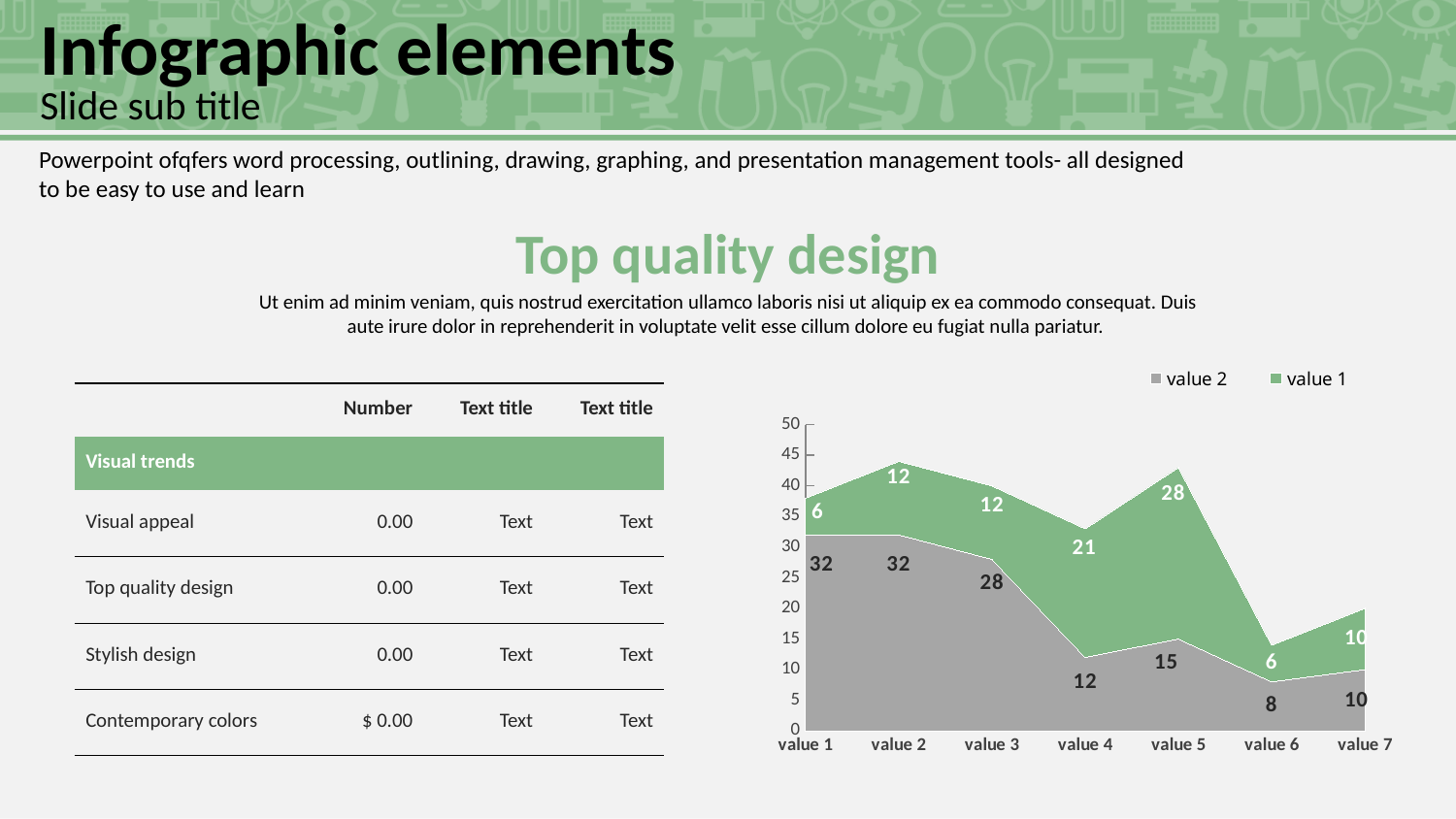
Does the series 'value 2' rise or fall from category 'value 3' to category 'value 4'? fall How many series does the chart legend list? 2 At which category is the series 'value 1' highest? value 5 What type of chart is shown on the slide? area chart What is the difference between the series 'value 2' values at category 'value 1' and category 'value 3'? 4 Which is larger at category 'value 5': the series 'value 1' or the series 'value 2'? value 1 What is the data label for the series 'value 1' at the category 'value 5'? 28 How many categories are shown along the x axis of the chart? 7 What is the stacked total of the two series at category 'value 2'? 44 Which series is shown in green in the chart? value 1 What is the data label for the series 'value 2' at the category 'value 4'? 12 At which category is the series 'value 2' lowest? value 6